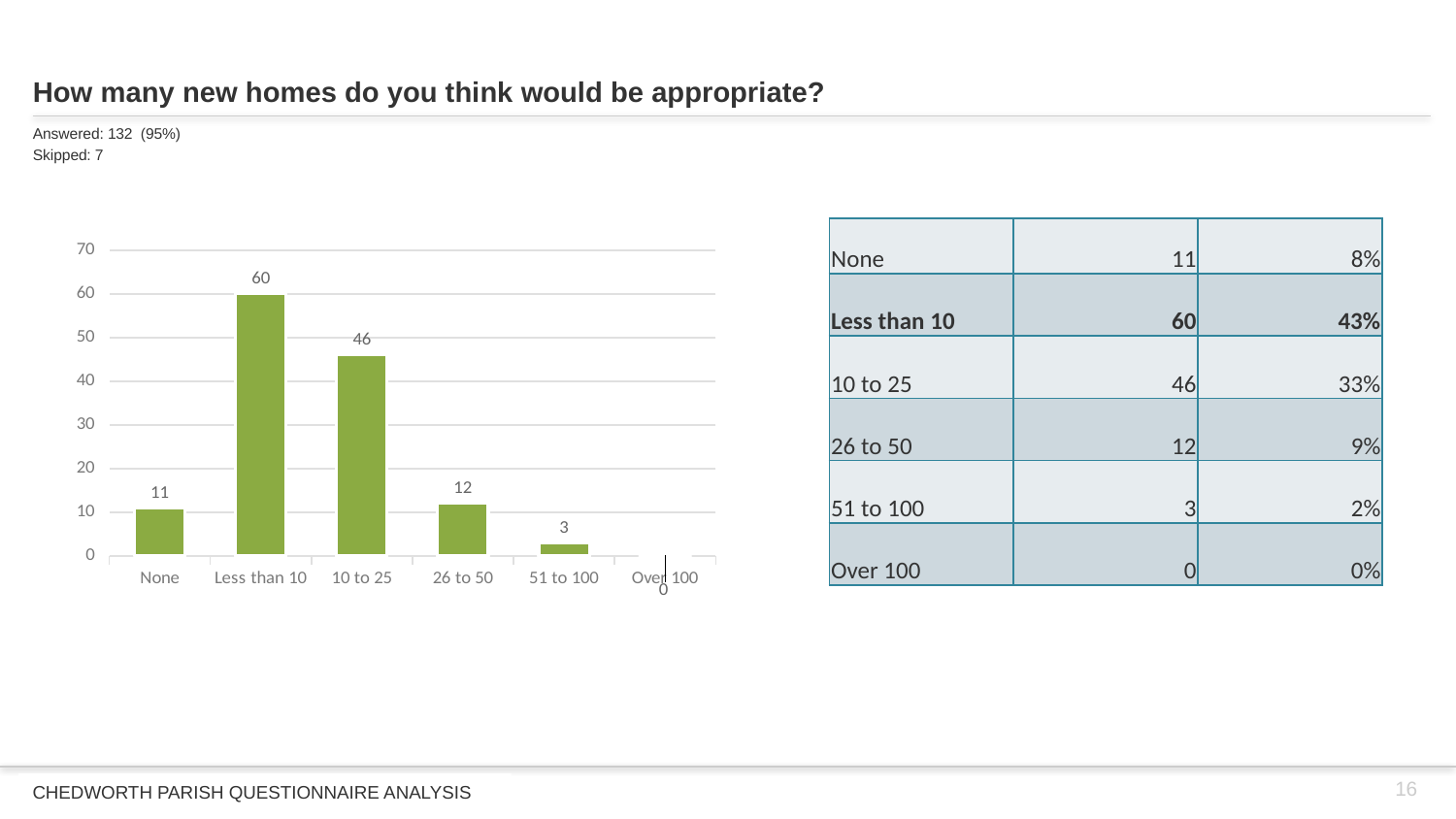
Is the value for "10 to 25" greater or less than 40? greater What is the difference between the values for "None" and "26 to 50"? 1 What is the highest value shown on the y axis? 70 Which is larger, the value for "None" or the value for "26 to 50"? 26 to 50 What is the value for "51 to 100"? 3 What is the value for "Less than 10"? 60 What is the value for "10 to 25"? 46 What kind of chart is shown on the slide? bar chart Which category has the highest value? Less than 10 How many categories are shown on the x axis? 6 Which category has the lowest value? Over 100 What is the difference between the values for "Less than 10" and "10 to 25"? 14